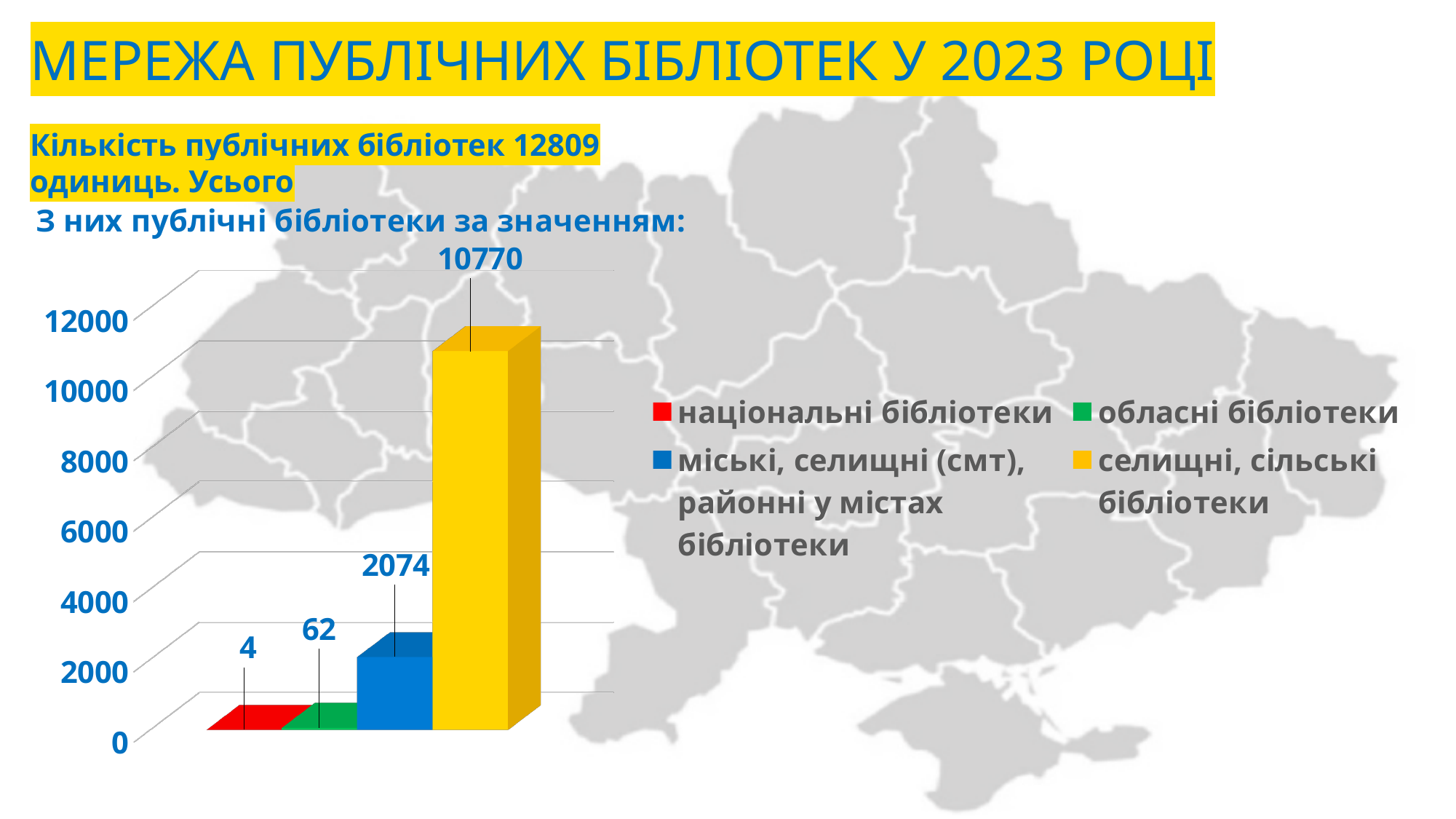
What is the value for національні бібліотеки? 4 What is the value for міські, селищні (смт), районні у містах бібліотеки? 2074 Is the value for селищні, сільські бібліотеки greater or less than 10000? greater What is the difference between the values for селищні, сільські бібліотеки and міські, селищні (смт), районні у містах бібліотеки? 8696 What is the value for селищні, сільські бібліотеки? 10770 What kind of chart is shown on the slide? bar chart Which category has the highest value? селищні, сільські бібліотеки How many series does the legend list? 4 Which is larger: the value for обласні бібліотеки or the value for національні бібліотеки? обласні бібліотеки What is the value for обласні бібліотеки? 62 Which category has the lowest value? національні бібліотеки What colour is the bar for селищні, сільські бібліотеки? yellow